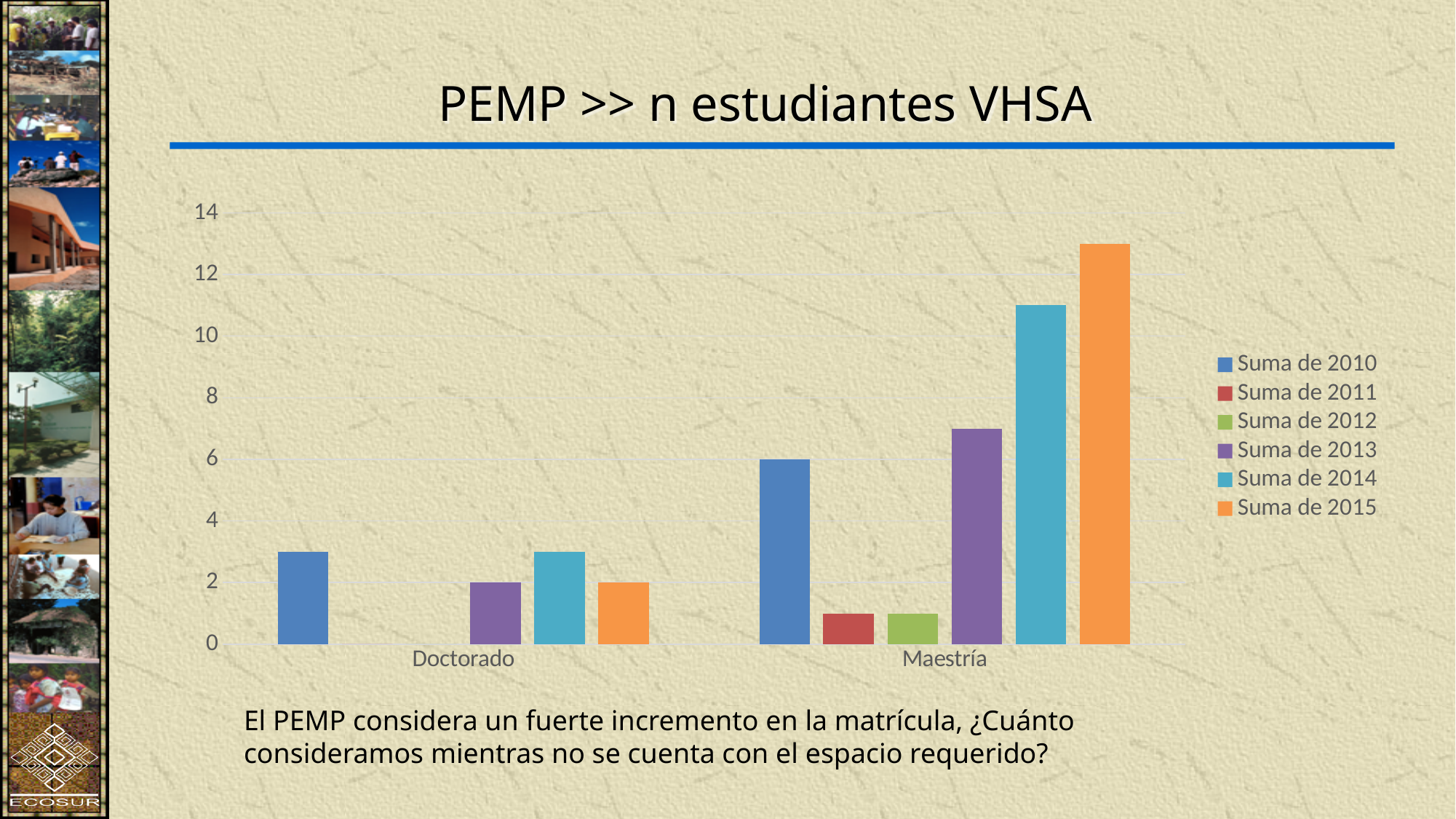
Which is larger in the Maestría category, Suma de 2013 or Suma de 2010? Suma de 2013 How many series does the legend list? 6 Is the value for Suma de 2011 in the Maestría category greater or less than 2? less What kind of chart is shown on the slide? bar chart How many categories are shown on the x axis? 2 What is the value for Suma de 2010 in the Maestría category? 6 What is the title of the chart's slide? PEMP >> n estudiantes VHSA What is the value for Suma de 2013 in the Doctorado category? 2 Is the value for Suma de 2015 in the Maestría category greater or less than 12? greater What is the value for Suma de 2015 in the Doctorado category? 2 Is the value for Suma de 2014 in the Maestría category greater or less than 10? greater Which series has the highest value in the Maestría category? Suma de 2015